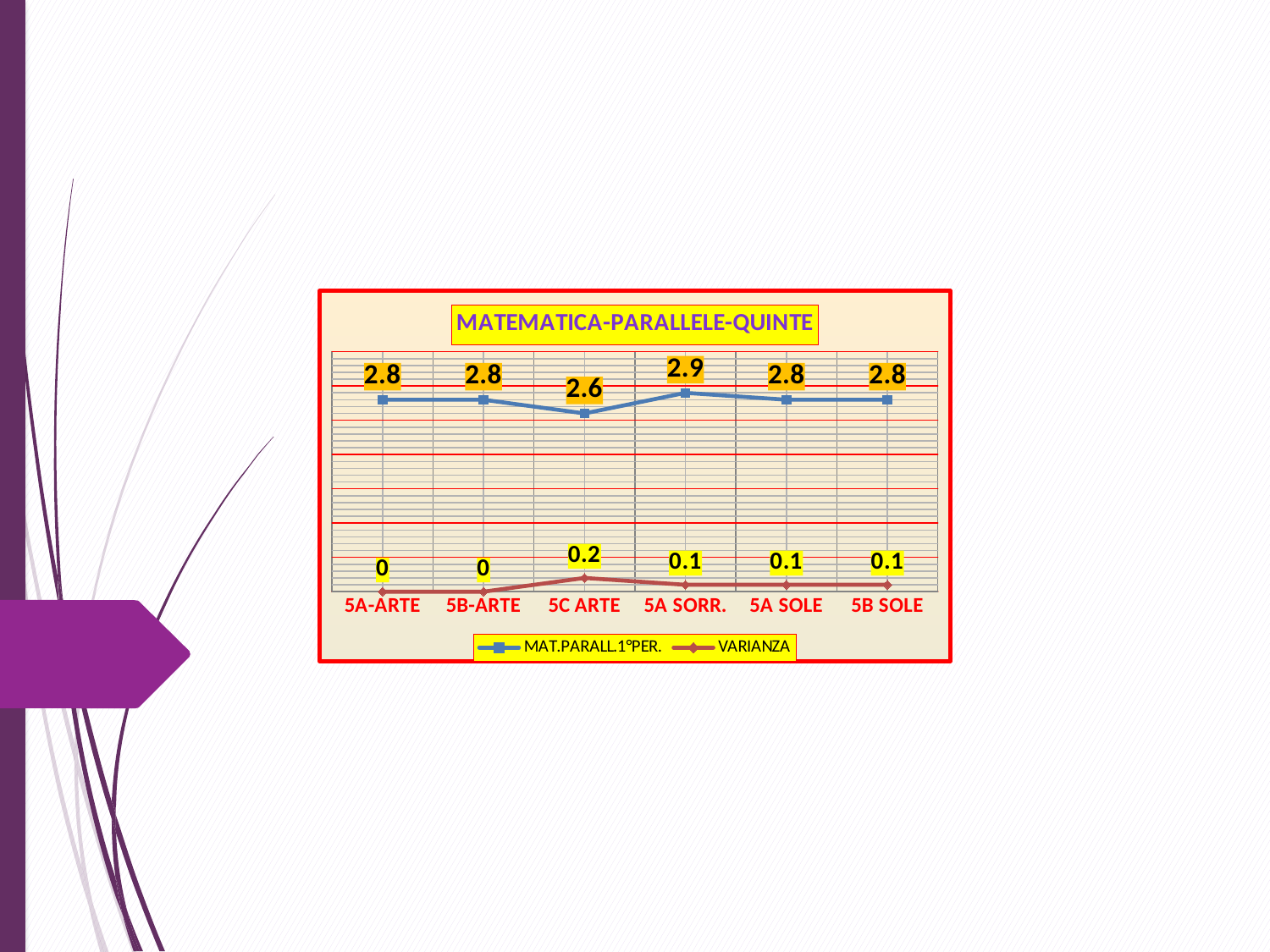
What is the MAT.PARALL.1°PER. value for 5C ARTE? 2.6 What type of chart is shown? Line chart How many categories are shown on the x axis? 6 Which category has the highest VARIANZA value? 5C ARTE What is the MAT.PARALL.1°PER. value for 5A SORR.? 2.9 How many series does the legend list? 2 What is the VARIANZA value for 5C ARTE? 0.2 Which category has the highest MAT.PARALL.1°PER. value? 5A SORR. What is the difference between the MAT.PARALL.1°PER. values for 5A SORR. and 5C ARTE? 0.3 Which is larger, the MAT.PARALL.1°PER. value for 5A SORR. or for 5B SOLE? 5A SORR. What is the VARIANZA value for 5A-ARTE? 0 Which category has the lowest MAT.PARALL.1°PER. value? 5C ARTE